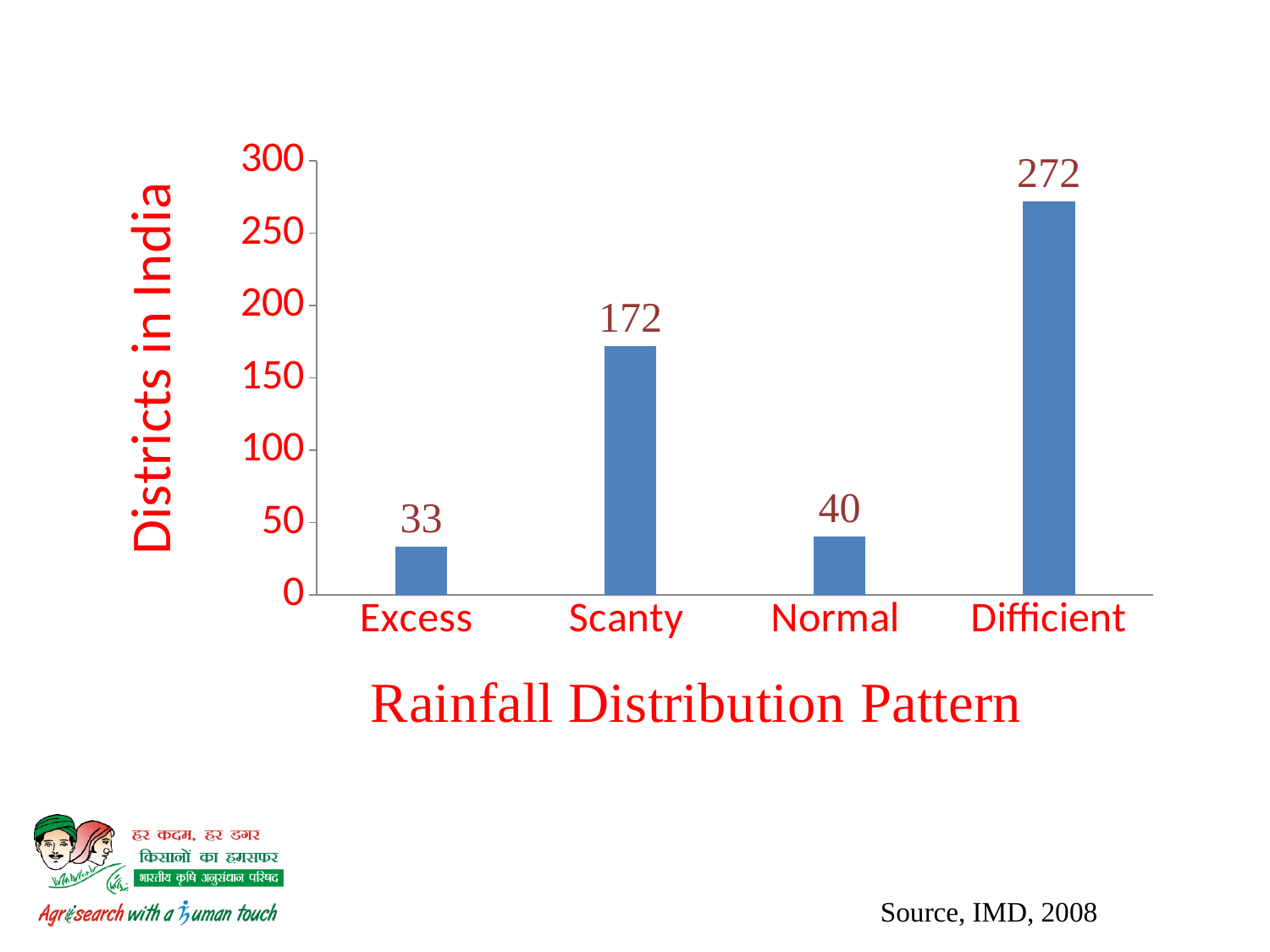
What type of chart is shown on the slide? Bar chart How many districts in India fall under the Excess rainfall distribution pattern? 33 What value is shown for the Normal category? 40 Which rainfall distribution pattern has the lowest number of districts? Excess Which has more districts, Scanty or Normal? Scanty How many rainfall distribution pattern categories are shown on the x axis? 4 What is the difference between the Normal and Excess values? 7 What is the number of districts for the Scanty rainfall pattern? 172 What is the label of the y axis? Districts in India Which rainfall distribution pattern has the highest number of districts? Difficient How many districts are in the Difficient category? 272 What is the difference between the number of districts in the Difficient and Scanty categories? 100